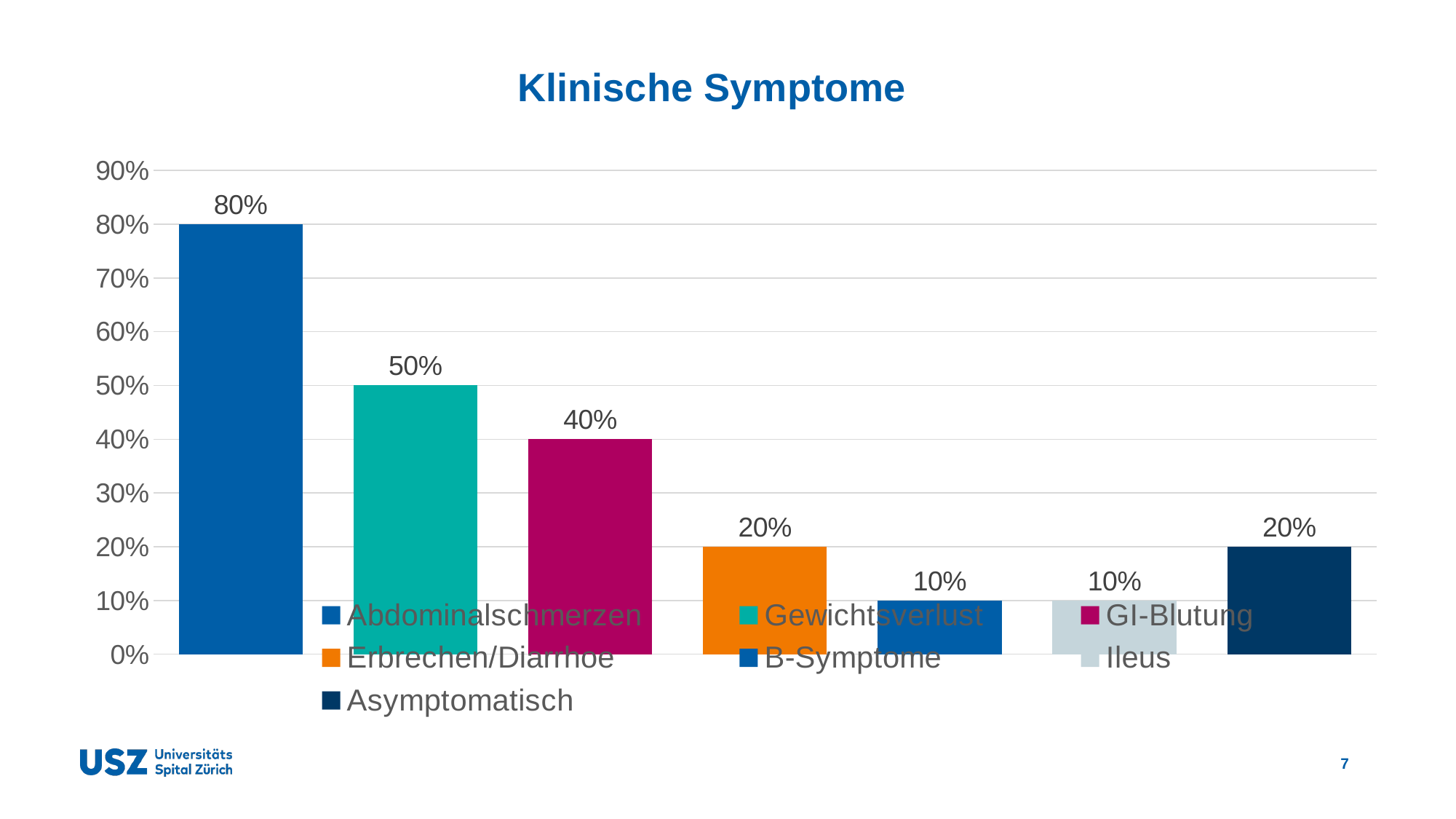
What is the value for GI-Blutung? 40% How many entries does the legend list? 7 Which is larger, the value for GI-Blutung or the value for Erbrechen/Diarrhoe? GI-Blutung What is the value for Abdominalschmerzen? 80% How many bars are plotted in the chart? 7 What is the difference between the values for Abdominalschmerzen and Gewichtsverlust? 30% What is the value for Gewichtsverlust? 50% Which symptom has the highest value? Abdominalschmerzen What type of chart is shown on the slide? bar chart What is the difference between the values for Erbrechen/Diarrhoe and B-Symptome? 10% What is the value for Asymptomatisch? 20% What is the title of the chart? Klinische Symptome